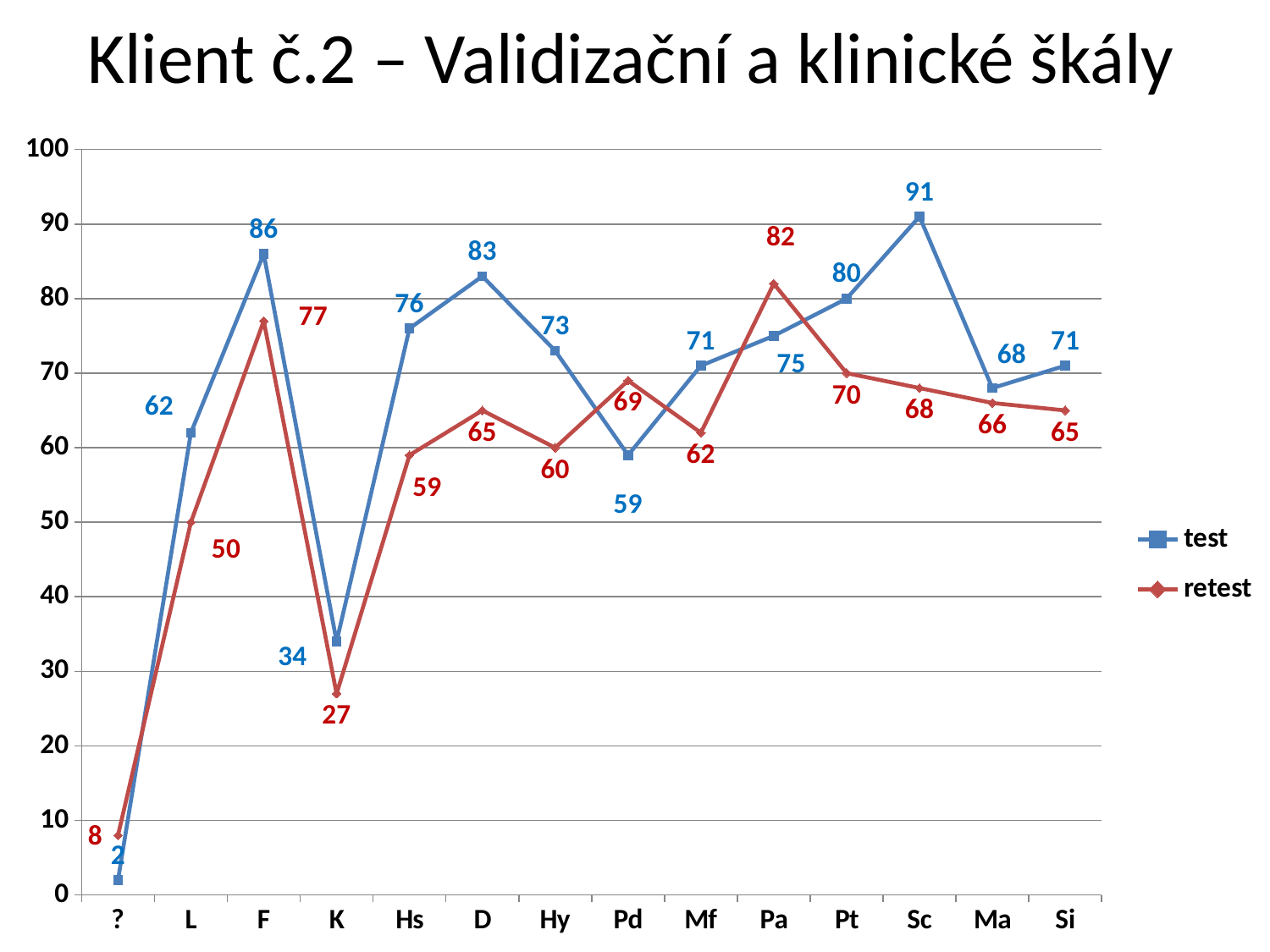
What is the test value for Sc? 91 Which is larger for Pa, the test value or the retest value? retest Which category has the lowest retest value? ? What is the difference between the test and retest values for F? 9 How many series does the legend list? 2 How many categories are shown on the x axis? 14 What is the test value for K? 34 What is the retest value for Pa? 82 What is the title of the slide? Klient č.2 – Validizační a klinické škály Which category has the highest test value? Sc What kind of chart is shown on the slide? line chart What is the difference between the test values for Sc and Ma? 23